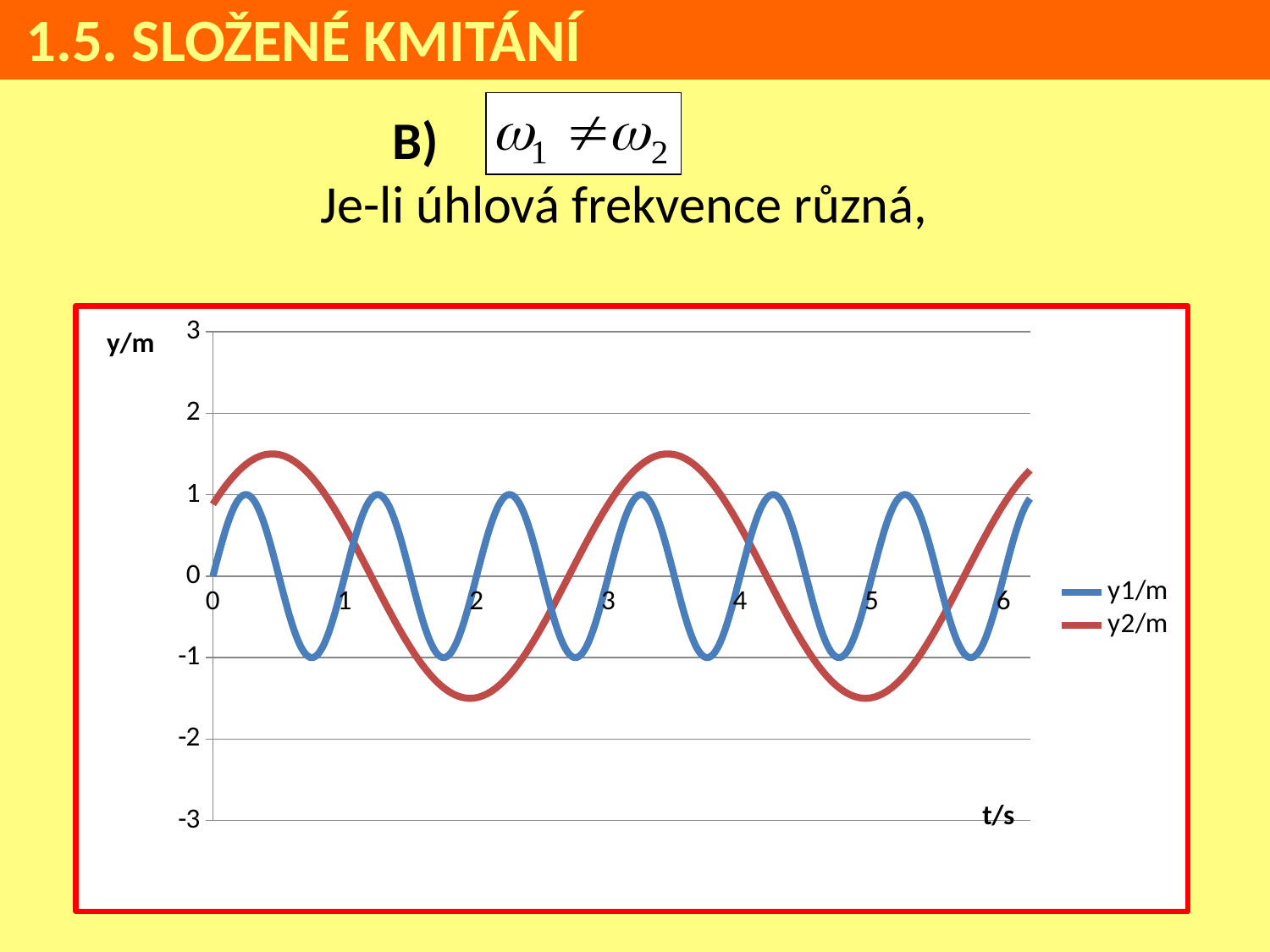
Is the peak value of the series y2/m greater or less than 2? less What is the value of y1/m at t = 0? 0 What colour is the line for the series y2/m? red What is the maximum value reached by the series y1/m? 1 What is the minimum value reached by the series y1/m? -1 What kind of chart is shown on the slide? line chart Is the lowest value of the series y2/m greater or less than -1? less How many series does the legend list? 2 What are the two series named in the legend? y1/m and y2/m Is the peak value of the series y2/m greater or less than 1? greater Which series has the larger amplitude, y1/m or y2/m? y2/m How many peaks does the series y1/m show between t = 0 and t = 6? 6